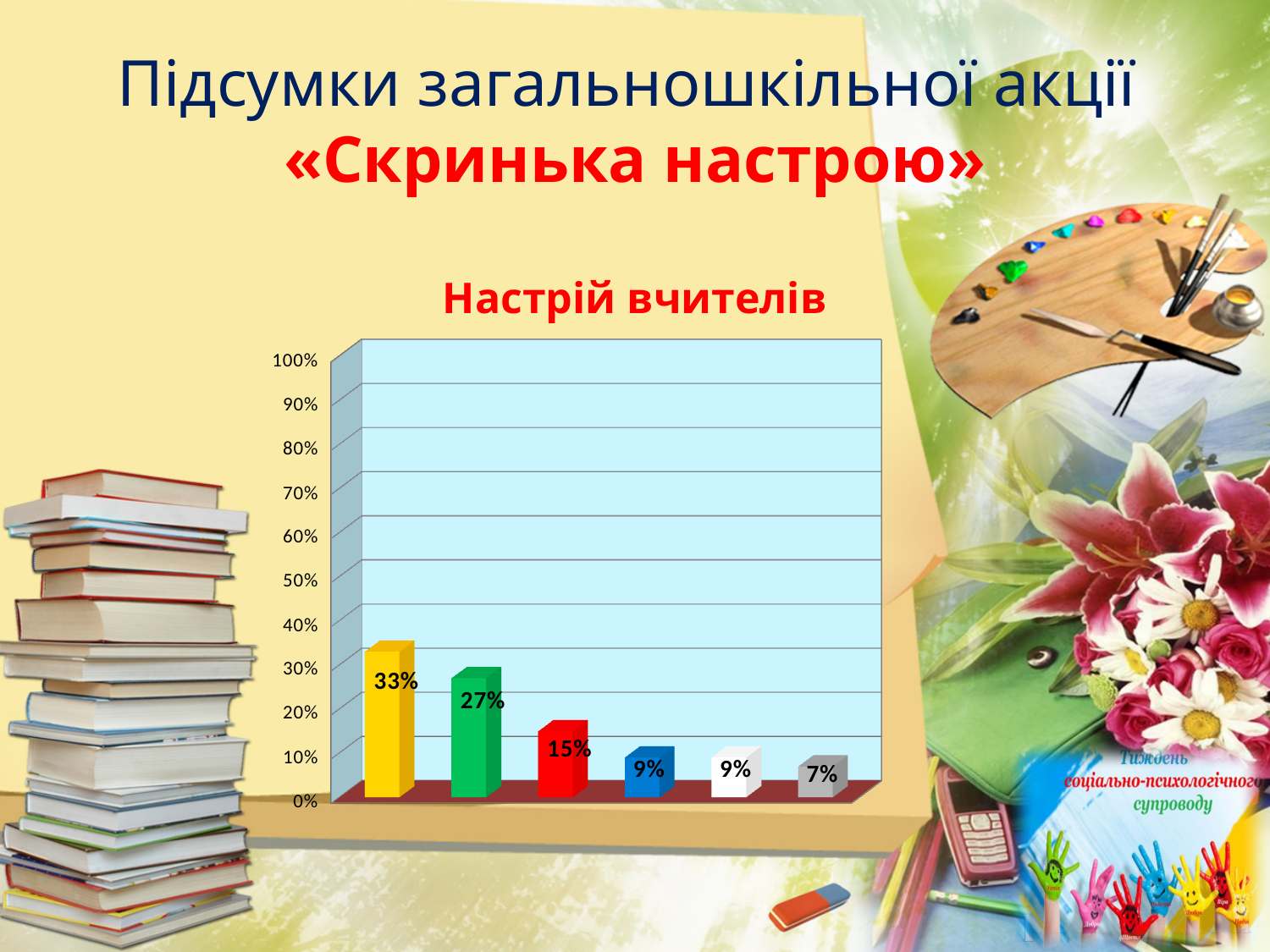
How many bars does the chart show? 6 Which colour bar has the highest value? yellow What value is shown on the green bar? 27% What value is shown on the yellow bar? 33% What is the title of the chart on the slide? Настрій вчителів Do the bar values rise or fall from left to right? fall What kind of chart is shown on the slide? bar chart What value is shown on the grey bar? 7% Which colour bar has the lowest value? grey Which is larger, the red bar or the blue bar? red bar What is the difference between the yellow bar and the green bar? 6% What value is shown on the red bar? 15%